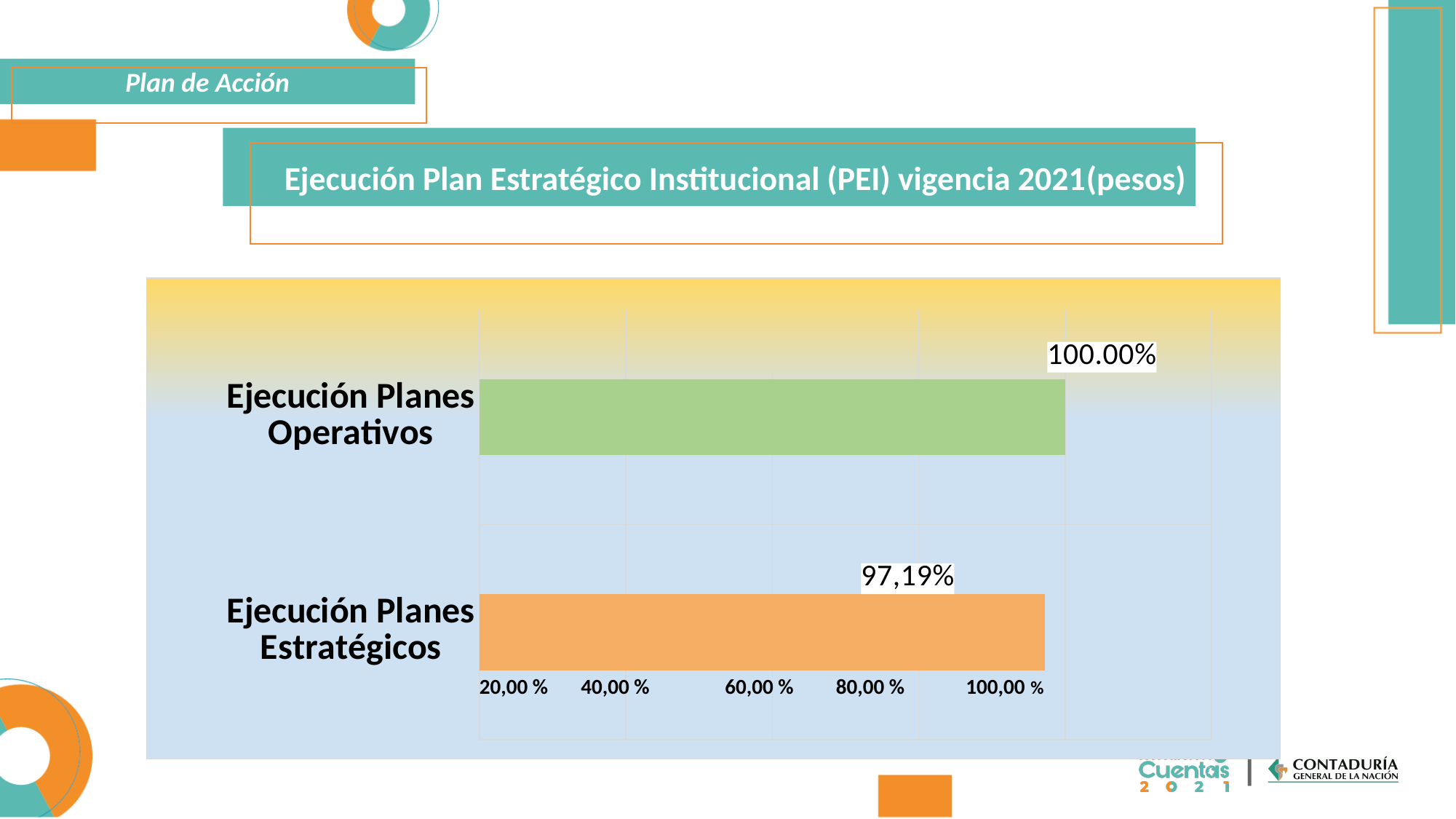
Which is larger, the value for Ejecución Planes Operativos or for Ejecución Planes Estratégicos? Ejecución Planes Operativos Which category has the lowest value? Ejecución Planes Estratégicos How many categories are shown in the chart? 2 What is the title of the chart? Ejecución Plan Estratégico Institucional (PEI) vigencia 2021(pesos) What colour is the bar for Ejecución Planes Estratégicos? orange What is the value for Ejecución Planes Operativos? 100.00% What kind of chart is shown on the slide? bar chart Is the value for Ejecución Planes Estratégicos greater or less than 80,00 %? greater Which category has the highest value? Ejecución Planes Operativos What is the value for Ejecución Planes Estratégicos? 97,19%